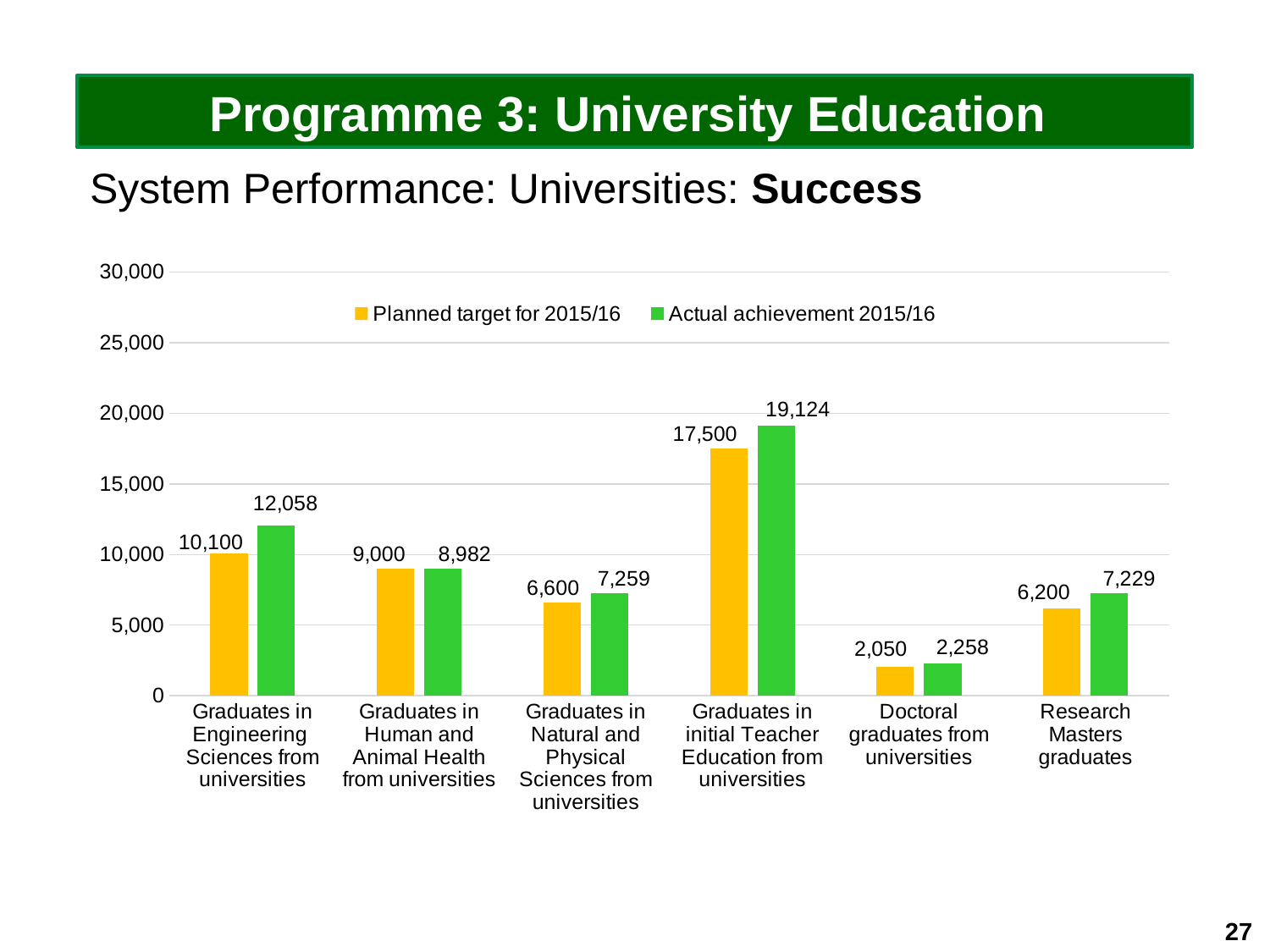
For Research Masters graduates, which is larger: the planned target for 2015/16 or the actual achievement 2015/16? Actual achievement 2015/16 What kind of chart is shown on the slide? Bar chart What is the difference between the planned target and the actual achievement for Graduates in Human and Animal Health from universities? 18 Which category has the lowest planned target for 2015/16? Doctoral graduates from universities How many series does the chart's legend list? 2 What was the actual achievement in 2015/16 for Graduates in initial Teacher Education from universities? 19,124 What was the actual achievement in 2015/16 for Doctoral graduates from universities? 2,258 What is the difference between the actual achievement and the planned target for Graduates in Engineering Sciences from universities? 1,958 What was the planned target for 2015/16 for Graduates in Engineering Sciences from universities? 10,100 Is the planned target for Graduates in initial Teacher Education from universities greater or less than 15,000? greater How many categories are shown on the x axis of the chart? 6 Which category has the highest actual achievement for 2015/16? Graduates in initial Teacher Education from universities